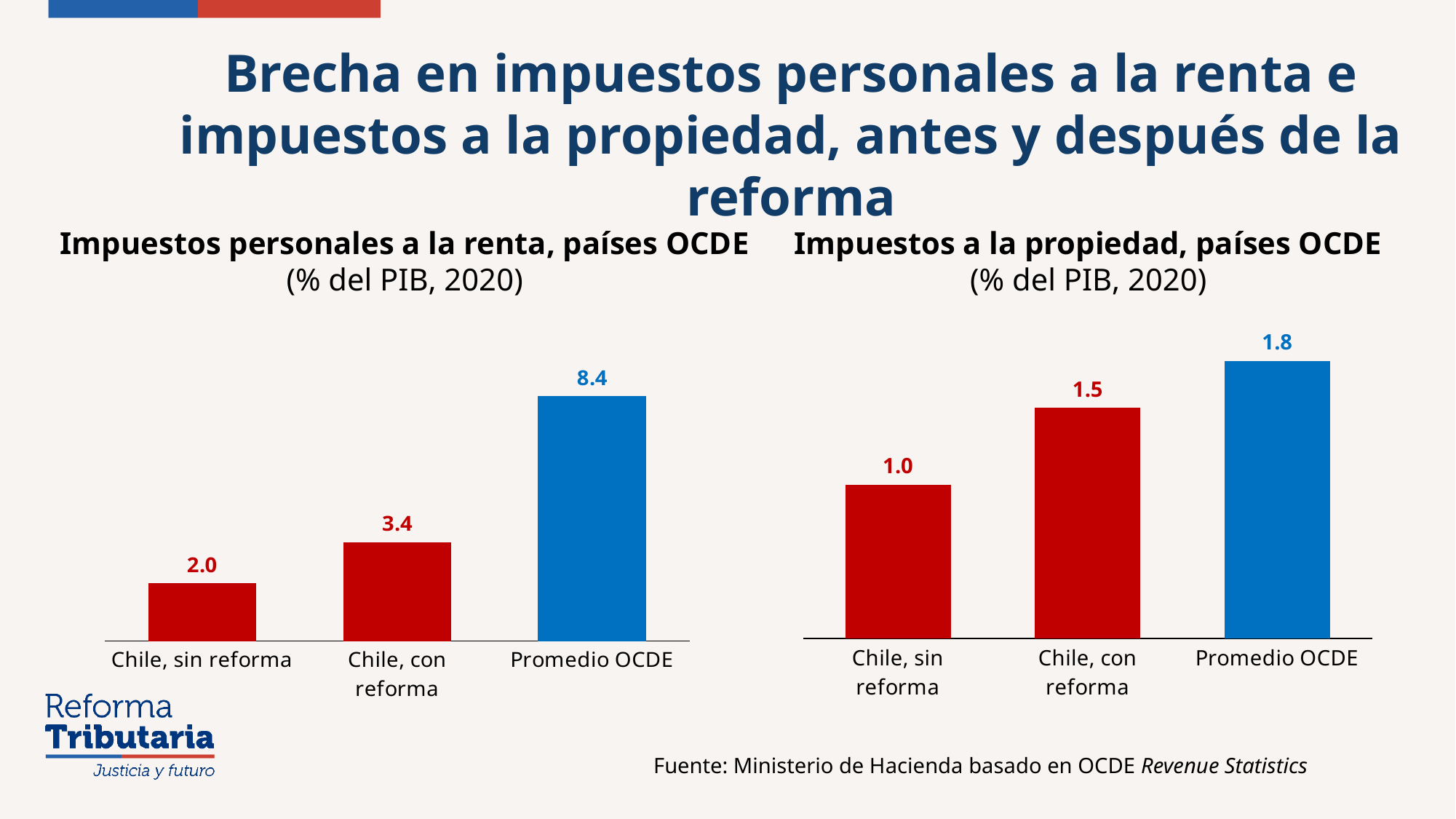
In the left chart (Impuestos personales a la renta, países OCDE), what is the value for Chile, sin reforma? 2.0 How many categories are shown in the left chart (Impuestos personales a la renta, países OCDE)? 3 In the right chart (Impuestos a la propiedad, países OCDE), which is larger: Chile, con reforma or Promedio OCDE? Promedio OCDE In the right chart (Impuestos a la propiedad, países OCDE), which category has the highest value? Promedio OCDE In the right chart (Impuestos a la propiedad, países OCDE), what colour is the Promedio OCDE bar? Blue In the right chart (Impuestos a la propiedad, países OCDE), what is the value for Chile, con reforma? 1.5 In the right chart (Impuestos a la propiedad, países OCDE), what is the difference between Chile, con reforma and Chile, sin reforma? 0.5 In the left chart (Impuestos personales a la renta, países OCDE), what is the difference between Promedio OCDE and Chile, con reforma? 5.0 In the left chart (Impuestos personales a la renta, países OCDE), what is the value for Promedio OCDE? 8.4 What kind of chart is the right chart (Impuestos a la propiedad, países OCDE)? Bar chart In the left chart (Impuestos personales a la renta, países OCDE), which category has the lowest value? Chile, sin reforma In the left chart (Impuestos personales a la renta, países OCDE), do the values rise or fall from left to right? Rise